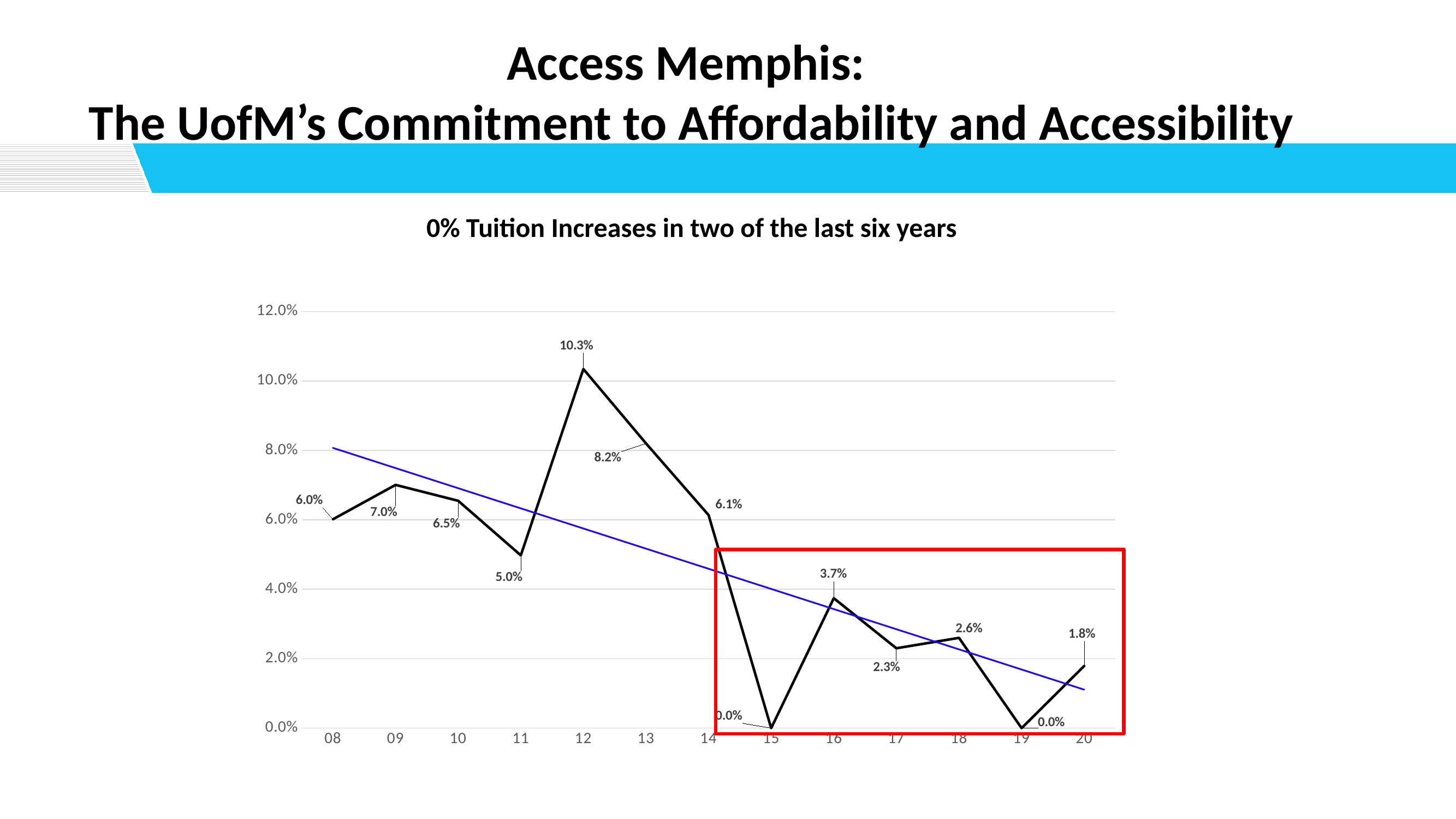
How many years are plotted on the x axis? 13 What is the value plotted for 16? 3.7% Which year has the highest tuition increase? 12 What kind of chart is shown on the slide? line chart What is the title of the chart? 0% Tuition Increases in two of the last six years What is the value plotted for 20? 1.8% What is the difference between the values for 12 and 13? 2.1% What is the tuition increase value for 12? 10.3% Is the value for 13 greater or less than 8.0%? greater Does the blue trend line rise or fall from 08 to 20? fall Which years show a 0.0% tuition increase? 15 and 19 Which is larger, the value for 17 or the value for 18? 18